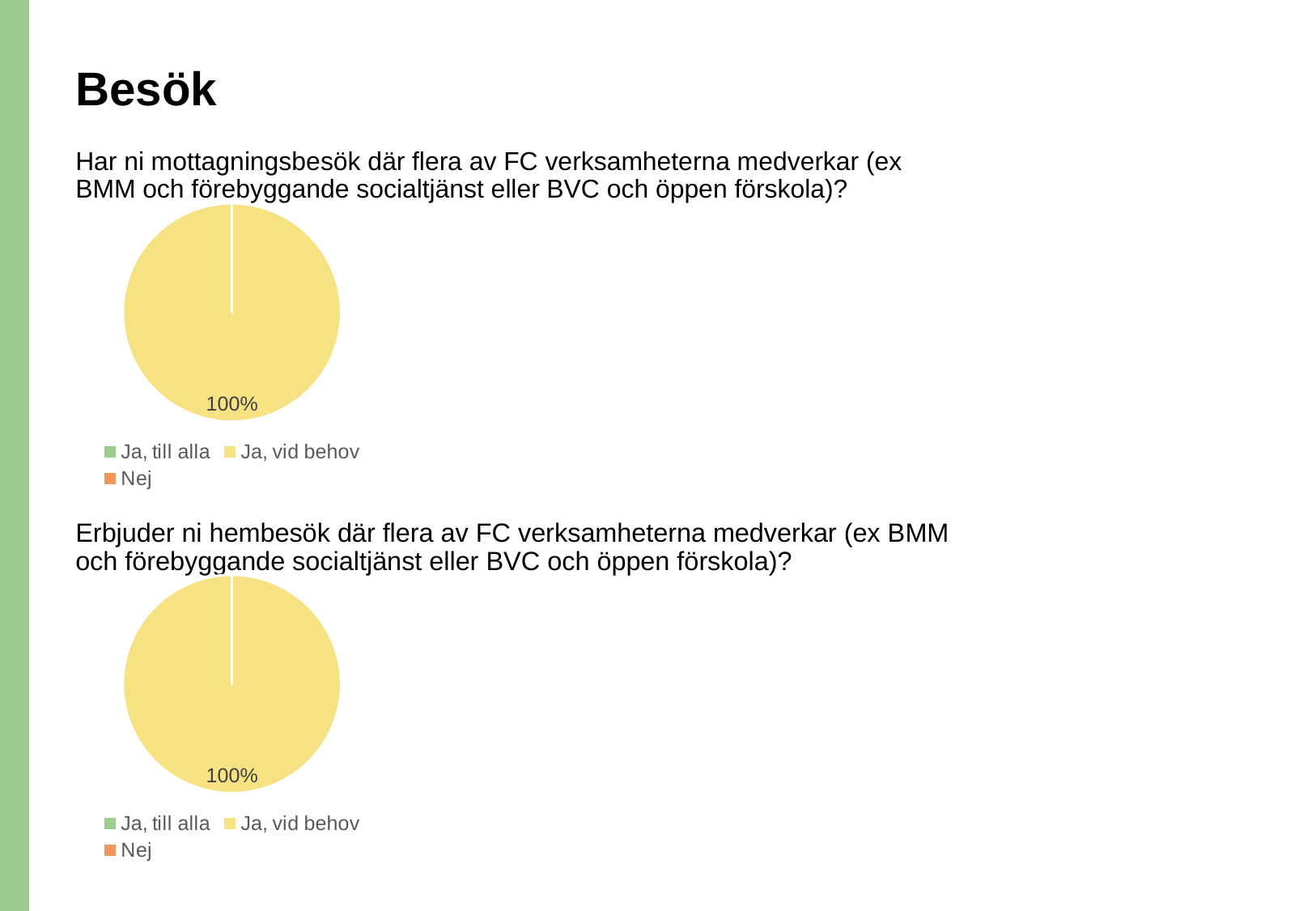
What kind of chart is the top chart on the slide? Pie chart In the top chart, which category makes up the whole pie? Ja, vid behov How many entries does the legend of the top chart list? 3 What kind of chart is the bottom chart on the slide? Pie chart What colour represents "Ja, till alla" in the legend of the top chart? Green How many entries does the legend of the bottom chart list? 3 What colour represents "Nej" in the legend of the bottom chart? Orange In the bottom chart (hembesök), what share of the pie does "Ja, vid behov" have? 100% In the top chart (mottagningsbesök), what share of the pie does "Ja, vid behov" have? 100% In the bottom chart, which category makes up the whole pie? Ja, vid behov In the top chart, is the share for "Ja, vid behov" greater or less than 50%? greater